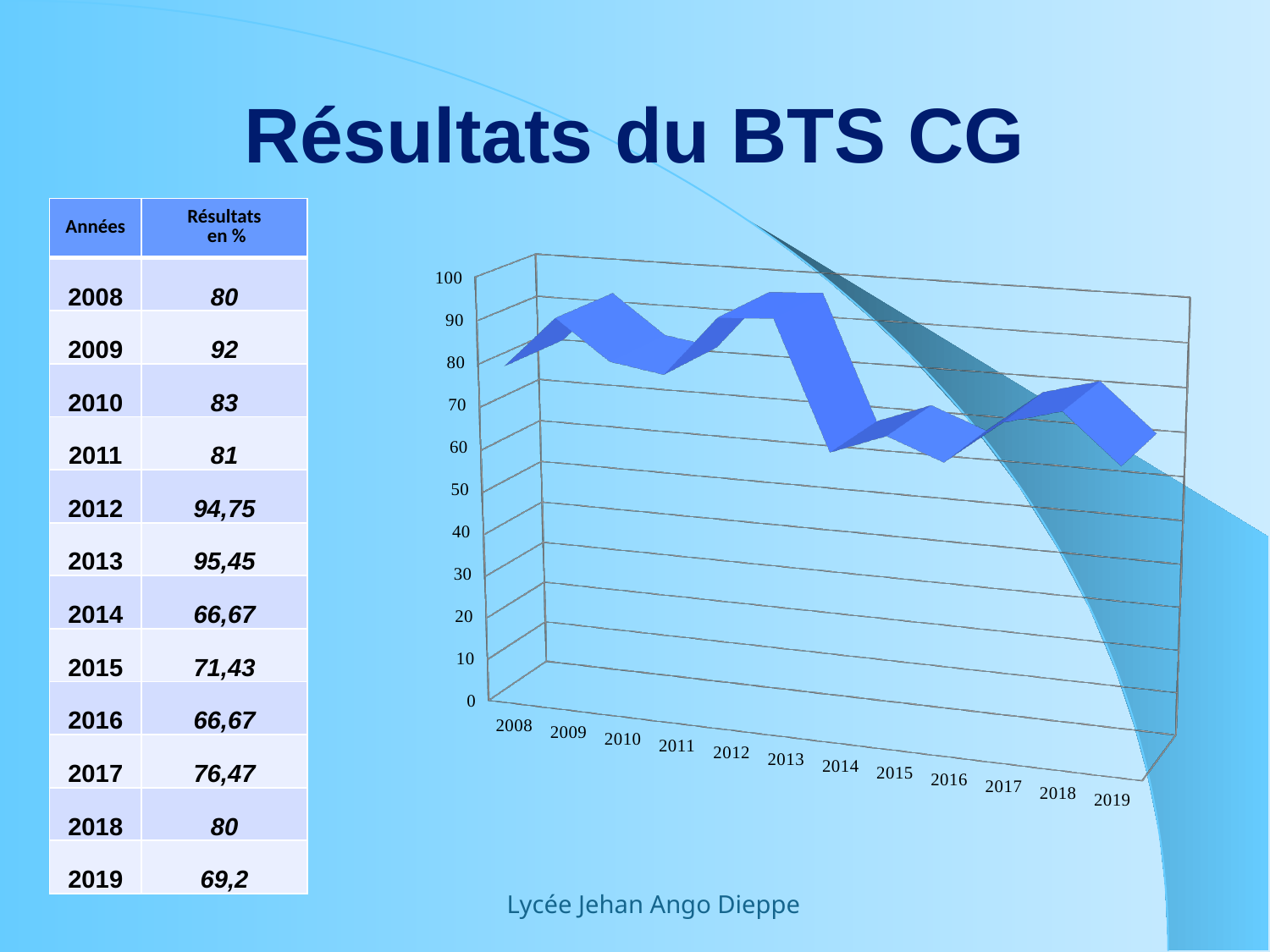
What is the result in % for 2009? 92 What is the result in % for 2019? 69,2 What is the title of the slide containing the chart? Résultats du BTS CG What kind of chart is shown on the slide? line chart How many years are plotted along the x axis of the chart? 12 Is the value for 2014 greater or less than 70? less Which year has the highest result? 2013 Do the results rise or fall from 2013 to 2014? fall Is the value for 2012 greater or less than 90? greater What is the result in % for 2013? 95,45 Which year has the higher result, 2009 or 2010? 2009 What is the difference between the results for 2009 and 2008? 12